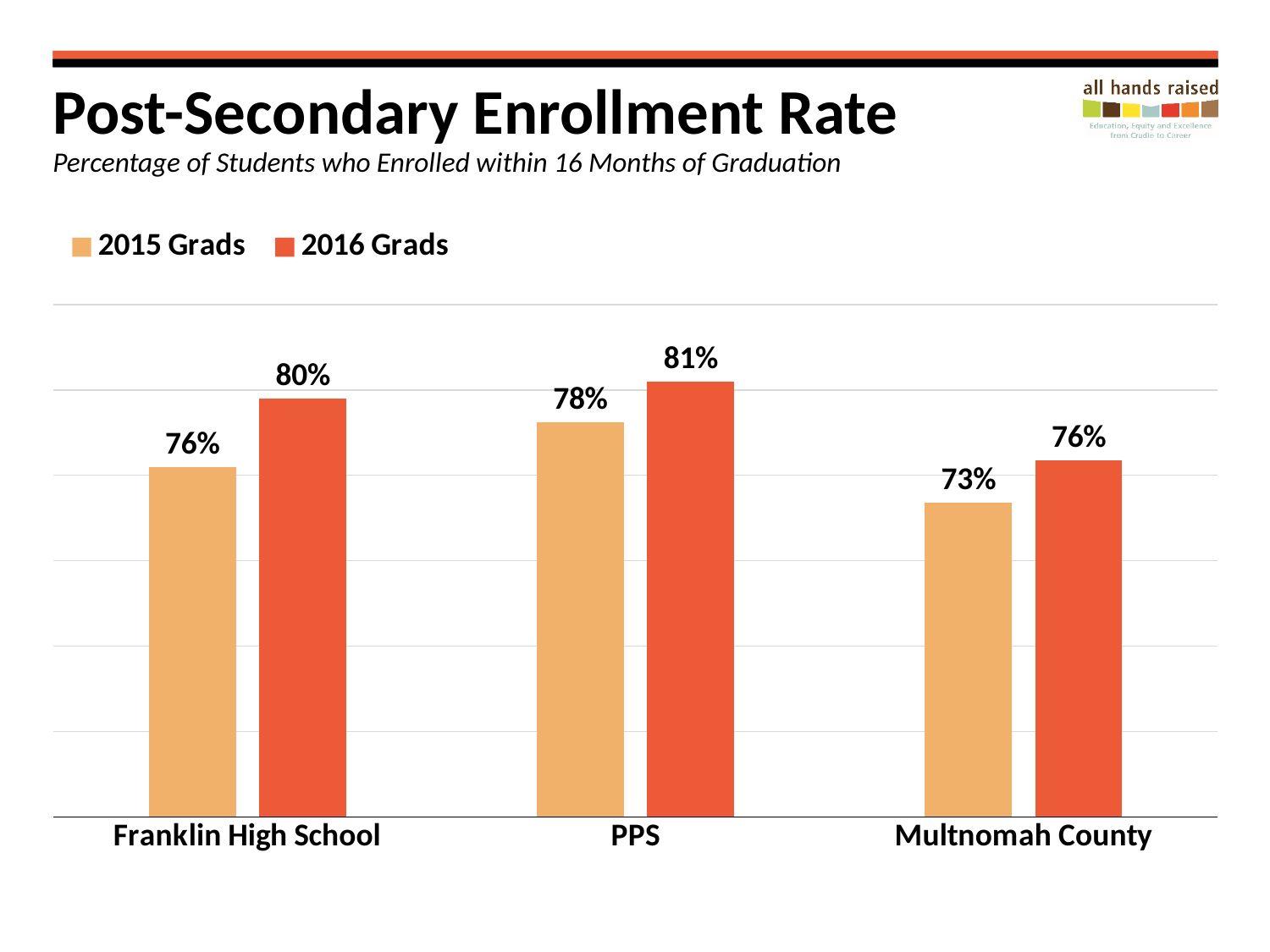
What is the post-secondary enrollment rate for 2016 Grads at PPS? 81% Which category has the highest 2016 Grads enrollment rate? PPS How many categories are shown on the x axis? 3 What is the post-secondary enrollment rate for 2015 Grads at Franklin High School? 76% How many series does the legend list? 2 Which is larger: the 2015 Grads rate at PPS or the 2016 Grads rate at Multnomah County? 2015 Grads rate at PPS What is the post-secondary enrollment rate for 2015 Grads in Multnomah County? 73% What kind of chart is shown on the slide? Bar chart What is the post-secondary enrollment rate for 2016 Grads in Multnomah County? 76% Which category has the lowest 2015 Grads enrollment rate? Multnomah County What is the difference between the 2016 Grads and 2015 Grads enrollment rates at Franklin High School? 4% What is the difference between the 2016 Grads enrollment rate at PPS and at Multnomah County? 5%